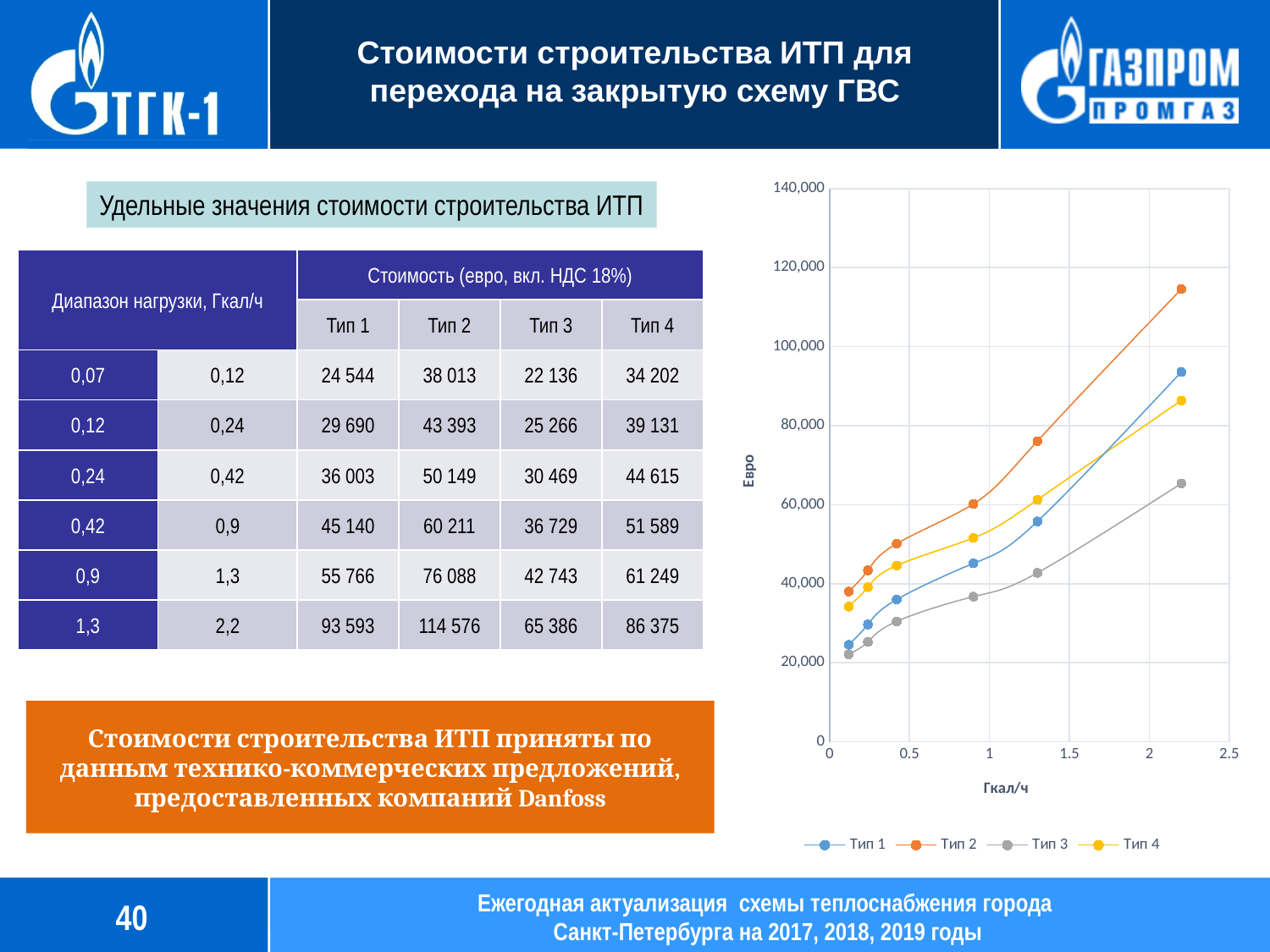
Is the value of Тип 1 at its rightmost point greater or less than 80,000? greater Which series has the lowest value at the rightmost point of the chart (around 2.2 Гкал/ч)? Тип 3 Is the value of Тип 2 at its rightmost point greater or less than 100,000? greater Is the value of Тип 3 at its rightmost point greater or less than 80,000? less What are the series names listed in the chart's legend? Тип 1, Тип 2, Тип 3, Тип 4 How many series does the chart's legend list? 4 How many data points are plotted for each series in the chart? 6 What kind of chart is shown on the right of the slide? line chart What is the label of the chart's vertical axis? Евро Do the values of the Тип 2 series rise or fall as Гкал/ч increases along the x axis? rise At around 0.9 Гкал/ч, which series has the larger value, Тип 2 or Тип 3? Тип 2 Which series has the highest value at the rightmost point of the chart (around 2.2 Гкал/ч)? Тип 2